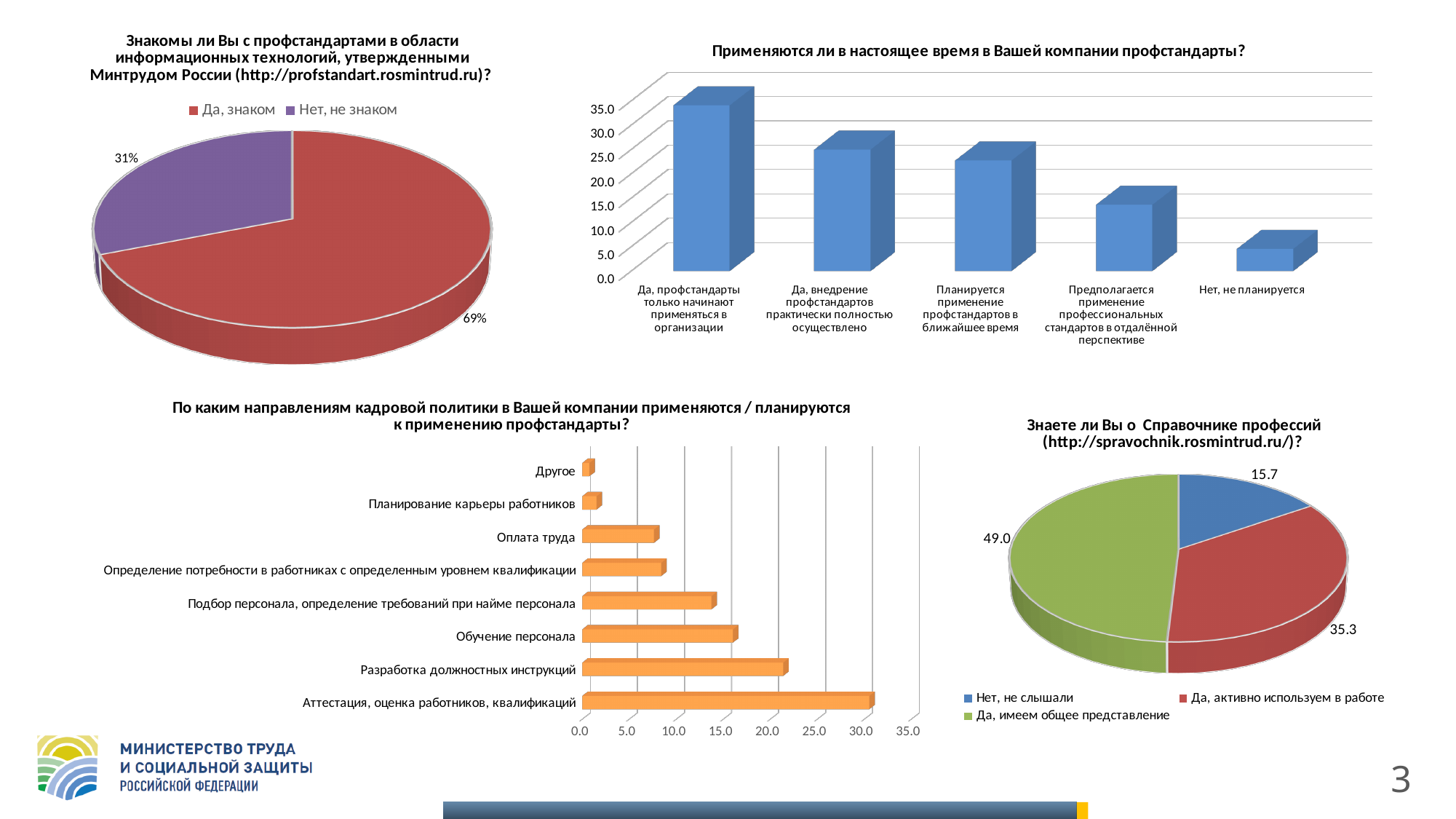
In the chart titled 'Применяются ли в настоящее время в Вашей компании профстандарты?', how many categories are shown? 5 In the pie chart titled 'Знакомы ли Вы с профстандартами в области информационных технологий...', what is the difference between the 'Да, знаком' and 'Нет, не знаком' shares? 38% In the chart titled 'По каким направлениям кадровой политики в Вашей компании применяются / планируются к применению профстандарты?', which is larger: 'Подбор персонала, определение требований при найме персонала' or 'Оплата труда'? Подбор персонала, определение требований при найме персонала In the chart titled 'По каким направлениям кадровой политики в Вашей компании применяются / планируются к применению профстандарты?', is the value for 'Аттестация, оценка работников, квалификаций' greater or less than 25.0? greater What kind of chart is the top-right chart titled 'Применяются ли в настоящее время в Вашей компании профстандарты?'? bar chart In the chart titled 'Применяются ли в настоящее время в Вашей компании профстандарты?', is the value for 'Нет, не планируется' greater or less than 10.0? less In the chart titled 'По каким направлениям кадровой политики в Вашей компании применяются / планируются к применению профстандарты?', which category has the lowest value? Другое In the pie chart titled 'Знаете ли Вы о Справочнике профессий', what value is labelled for 'Да, имеем общее представление'? 49.0 In the chart titled 'По каким направлениям кадровой политики в Вашей компании применяются / планируются к применению профстандарты?', how many categories are listed? 8 In the chart titled 'Применяются ли в настоящее время в Вашей компании профстандарты?', which category has the highest value? Да, профстандарты только начинают применяться в организации In the pie chart titled 'Знакомы ли Вы с профстандартами в области информационных технологий...', what share is labelled for 'Да, знаком'? 69% In the pie chart titled 'Знаете ли Вы о Справочнике профессий', how many entries does the legend list? 3